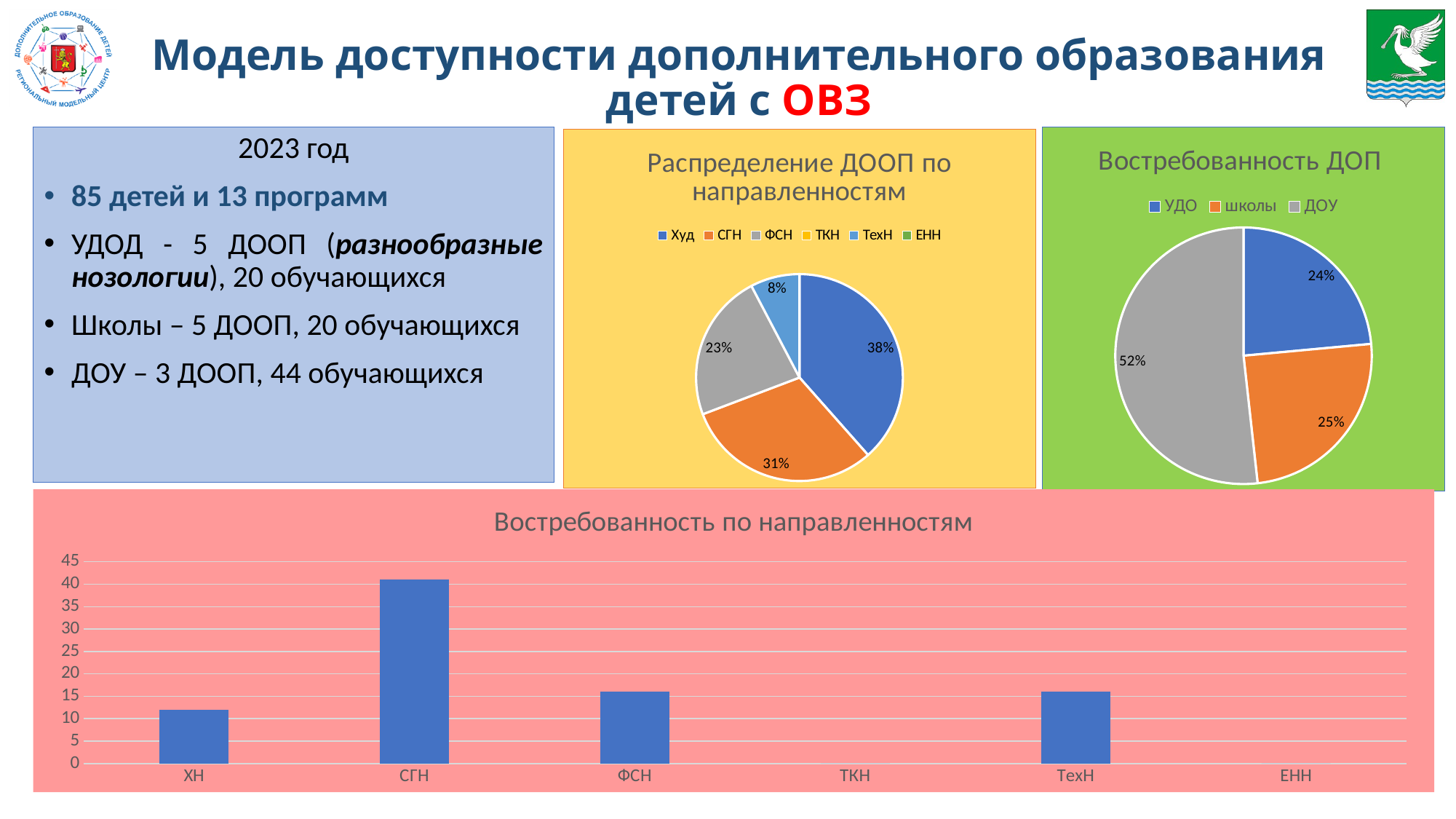
In the chart 'Востребованность по направленностям', which category has the highest value? СГН In the pie chart 'Востребованность ДОП', what share does ДОУ have? 52% In the pie chart 'Распределение ДООП по направленностям', how many entries does the legend list? 6 In the pie chart 'Востребованность ДОП', what share does УДО have? 24% In the pie chart 'Распределение ДООП по направленностям', what share does Худ have? 38% In the pie chart 'Распределение ДООП по направленностям', what share does СГН have? 31% In the pie chart 'Востребованность ДОП', which category has the largest share? ДОУ In the pie chart 'Распределение ДООП по направленностям', which category has the largest share? Худ In the pie chart 'Востребованность ДОП', what is the difference between the shares of ДОУ and школы? 27% In the chart 'Востребованность по направленностям', how many categories are shown on the x axis? 6 In the chart 'Востребованность по направленностям', is the value for СГН greater or less than 35? greater What kind of chart is 'Востребованность по направленностям'? bar chart